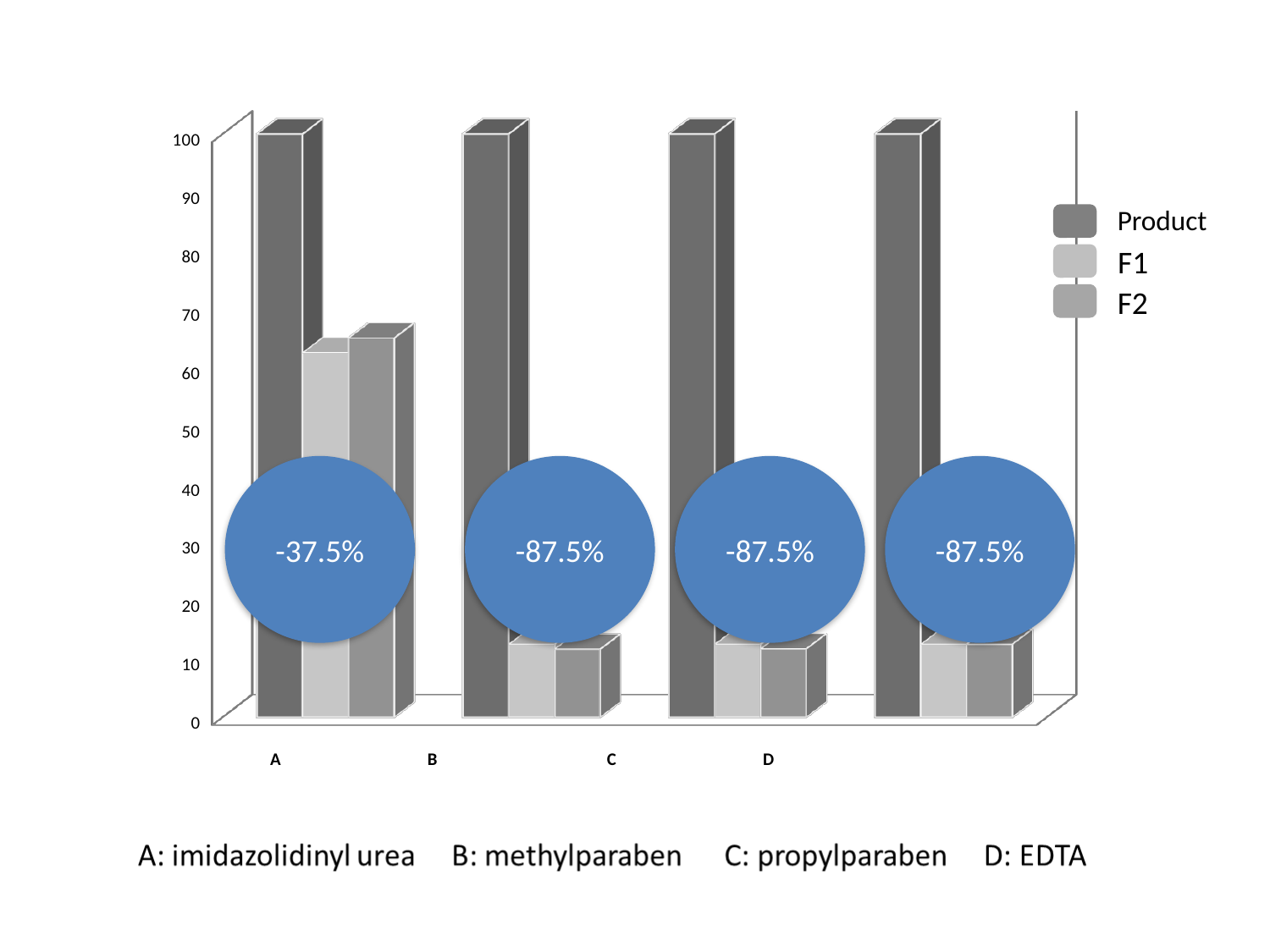
Is the Product value for category D greater or less than 90? greater What percentage is shown in the blue circle for category B? -87.5% Which is larger, the F1 value for category A or the F1 value for category C? A What percentage is shown in the blue circle for category D? -87.5% What percentage is shown in the blue circle for category A? -37.5% Is the F1 value for category A greater or less than 50? greater What are the three series named in the legend? Product, F1, F2 Which category has the highest F2 value? A What kind of chart is shown on the slide? bar chart Is the F1 value for category B greater or less than 20? less How many categories are shown on the x axis? 4 How many series does the legend list? 3